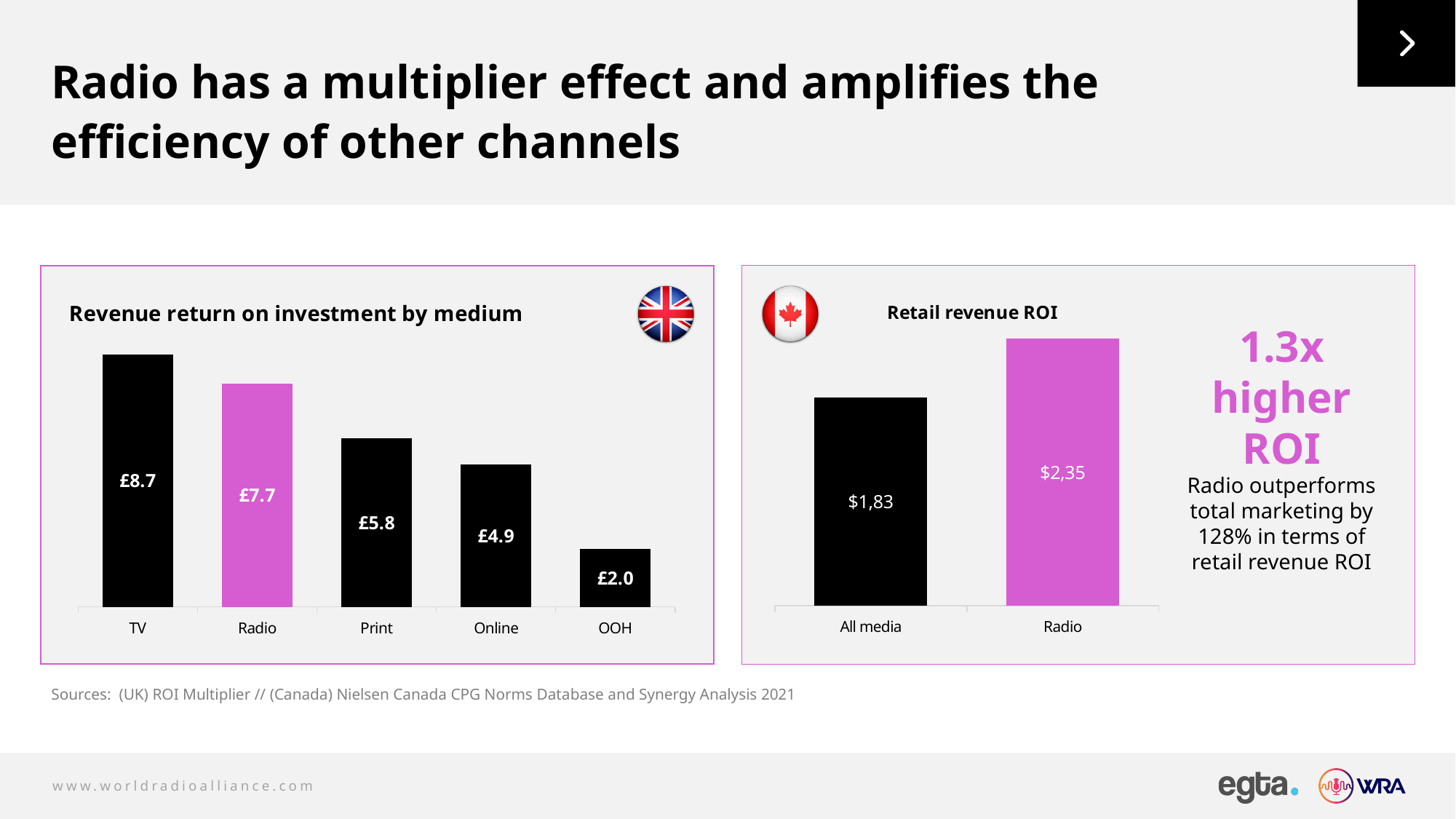
In the 'Retail revenue ROI' chart, what is the value for Radio? $2,35 In the 'Revenue return on investment by medium' chart, what is the difference between the TV and Radio values? £1.0 In the 'Revenue return on investment by medium' chart, which medium has the highest value? TV In the 'Revenue return on investment by medium' chart, what is the value for Online? £4.9 In the 'Revenue return on investment by medium' chart, which medium has the lowest value? OOH In the 'Revenue return on investment by medium' chart, which bar is coloured pink rather than black? Radio In the 'Revenue return on investment by medium' chart, which is larger, Print or Online? Print How many media categories are shown in the 'Revenue return on investment by medium' chart? 5 In the 'Retail revenue ROI' chart, what is the value for All media? $1,83 In the 'Retail revenue ROI' chart, which category has the higher value? Radio What kind of chart is the 'Retail revenue ROI' chart? Bar chart In the 'Revenue return on investment by medium' chart, what is the value for Radio? £7.7